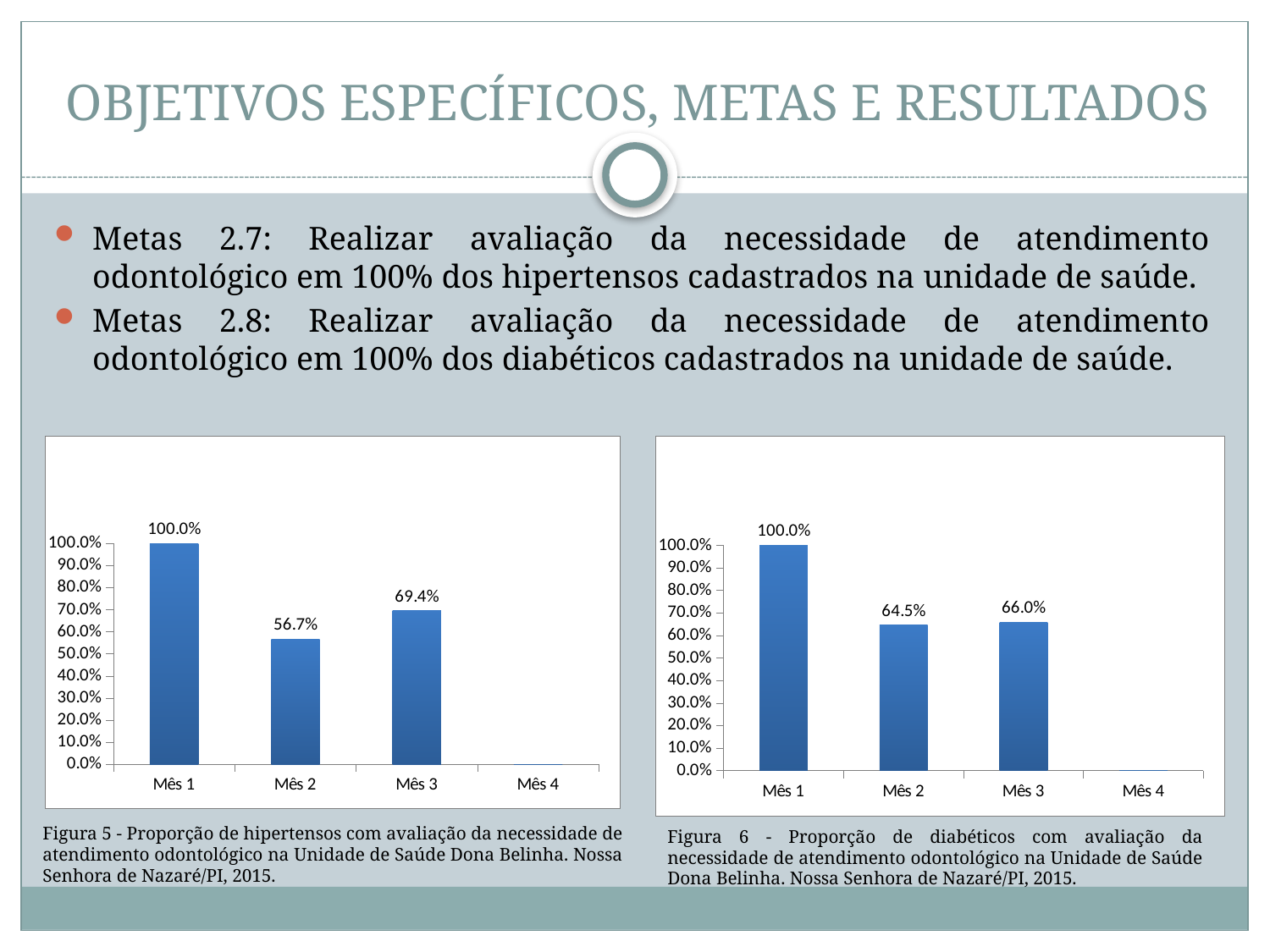
In the right chart (Figura 6), what is the difference between the values for Mês 1 and Mês 2? 35.5% In the left chart (Figura 5), what is the difference between the values for Mês 3 and Mês 2? 12.7% In the left chart (Figura 5), what is the value for Mês 3? 69.4% How many month categories are shown on the x axis of the right chart (Figura 6)? 4 In the left chart (Figura 5), what is the value for Mês 2? 56.7% What kind of chart is the left chart (Figura 5)? Bar chart In the left chart (Figura 5), is the value for Mês 2 greater or less than 60.0%? less In the left chart (Figura 5), which month has the highest value? Mês 1 In the right chart (Figura 6), what is the value for Mês 2? 64.5% In the right chart (Figura 6), what is the value for Mês 3? 66.0% In the right chart (Figura 6), which month has the highest value? Mês 1 In the left chart (Figura 5), which is larger, the value for Mês 2 or Mês 3? Mês 3